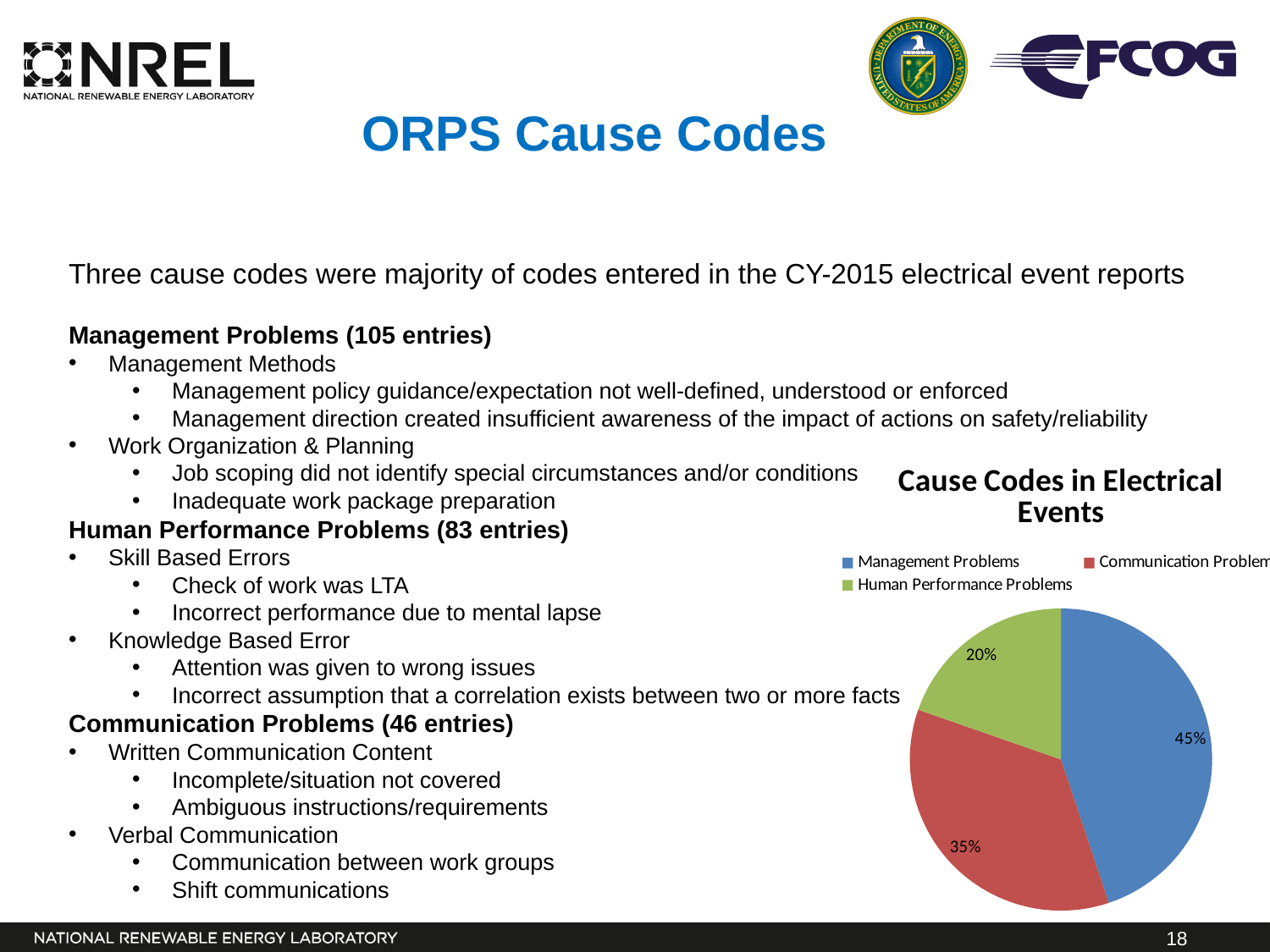
What type of chart is shown on the slide? pie chart What is the difference in percentage points between the Management Problems slice and the Human Performance Problems slice? 25 What colour is the Management Problems slice in the pie chart? blue How many slices does the pie chart have? 3 What is the title of the chart? Cause Codes in Electrical Events What share of the pie is Management Problems? 45% How many entries does the chart legend list? 3 Which slice is larger, Communication Problems or Human Performance Problems? Communication Problems What share of the pie is Communication Problems? 35% What share of the pie is Human Performance Problems? 20% Which category has the largest slice of the pie? Management Problems Which category has the smallest slice of the pie? Human Performance Problems